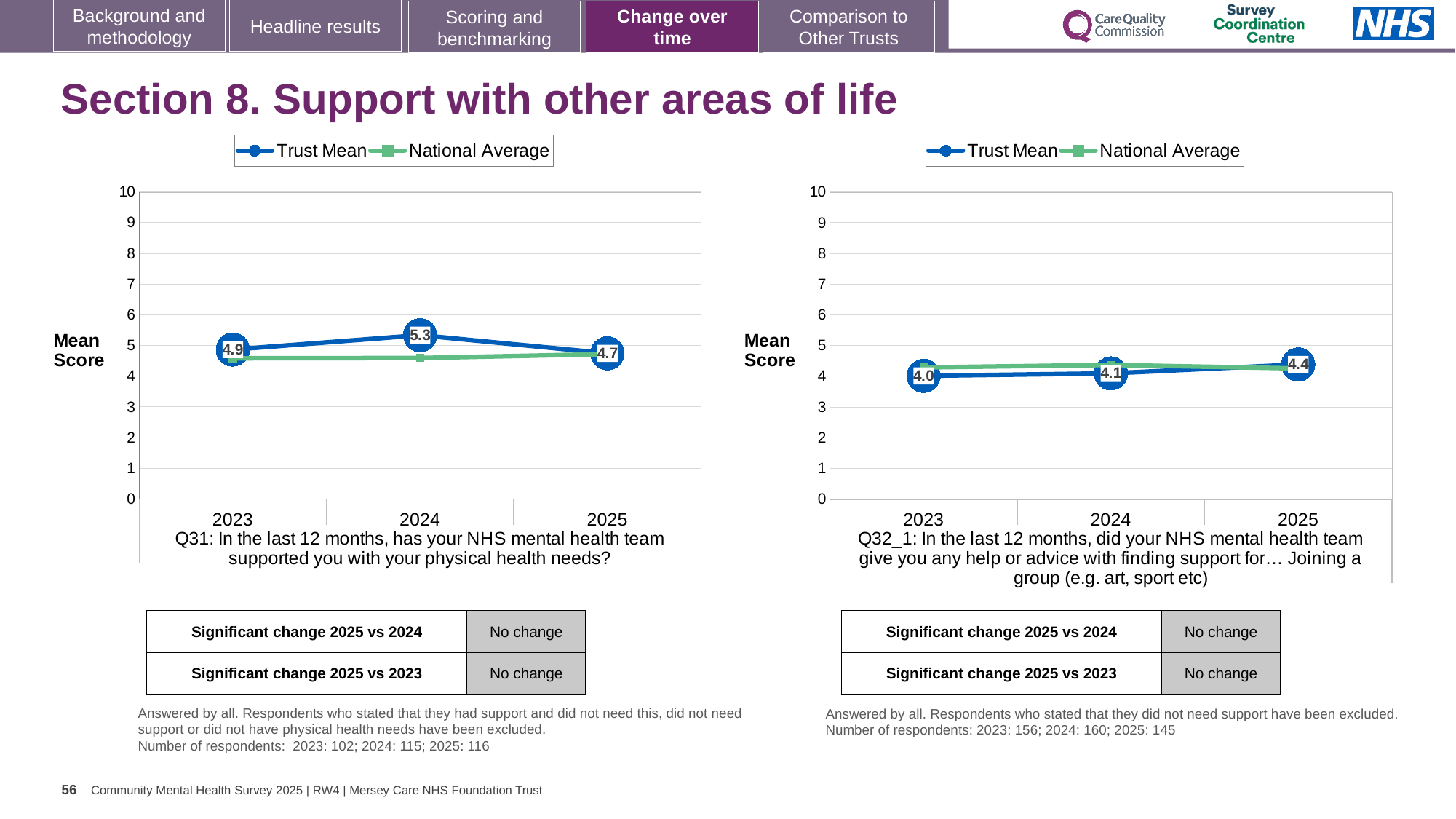
On the right chart (Q32_1), which year has the lowest Trust Mean? 2023 On the left chart (Q31), what is the difference between the Trust Mean in 2024 and in 2025? 0.6 On the left chart (Q31), what is the Trust Mean for 2024? 5.3 On the right chart (Q32_1), what is the difference between the Trust Mean in 2025 and in 2023? 0.4 On the right chart (Q32_1), what is the Trust Mean for 2025? 4.4 On the right chart (Q32_1), is the Trust Mean for 2023 greater or less than 5? less On the right chart (Q32_1), does the Trust Mean rise or fall from 2023 to 2025? rise On the left chart (Q31), in 2024, which is larger: the Trust Mean or the National Average? Trust Mean On the right chart (Q32_1), what is the Trust Mean for 2023? 4.0 On the left chart (Q31), which year has the highest Trust Mean? 2024 How many series does the legend of the left chart (Q31) list? 2 On the left chart (Q31), what is the Trust Mean for 2025? 4.7